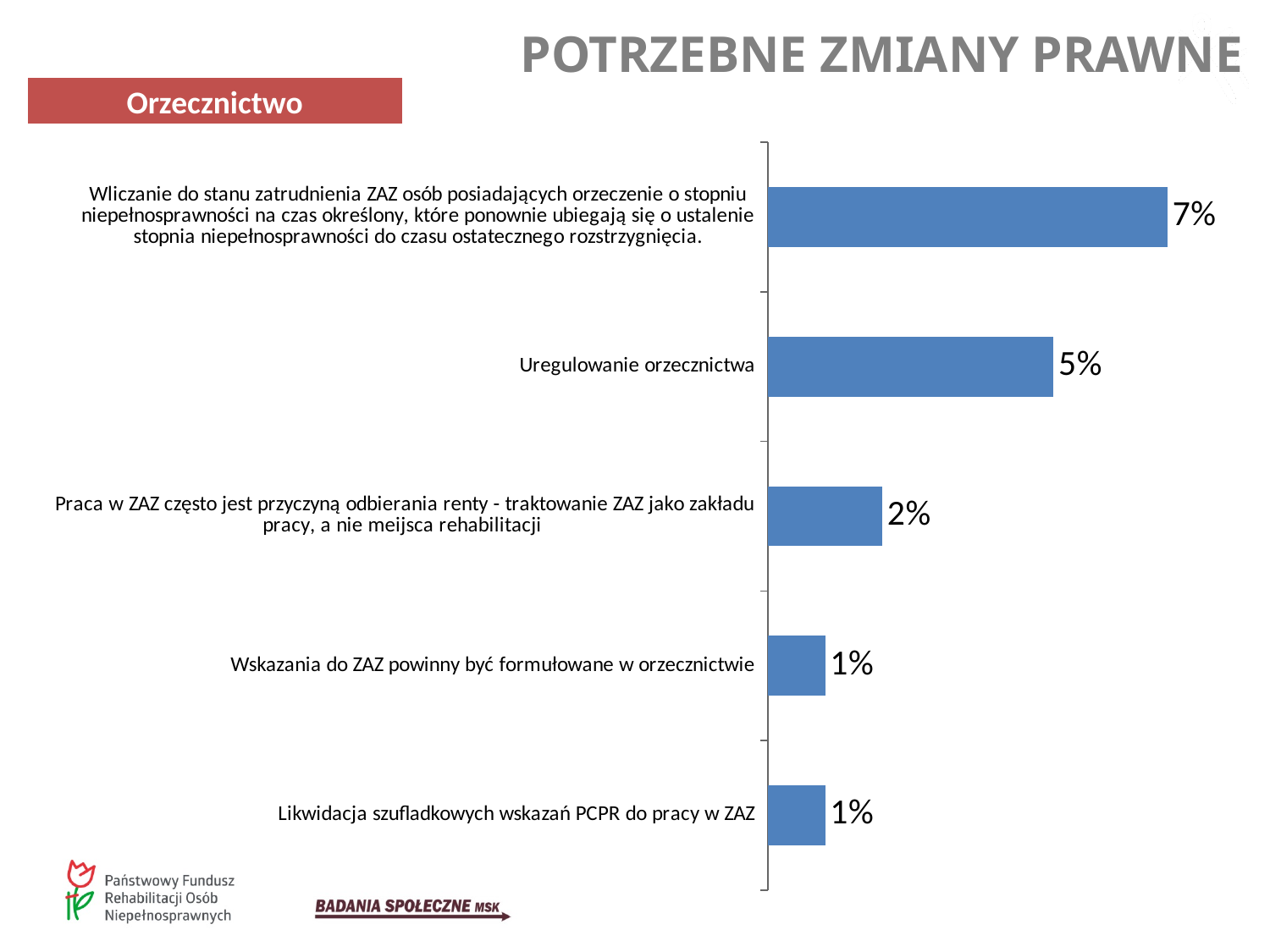
What is the value for "Uregulowanie orzecznictwa"? 5% How many categories are shown in the chart? 5 What is the value of the top bar, for the category beginning "Wliczanie do stanu zatrudnienia ZAZ"? 7% Which is larger: the value for "Uregulowanie orzecznictwa" or the value for "Praca w ZAZ często jest przyczyną odbierania renty"? Uregulowanie orzecznictwa What kind of chart is shown on the slide? Bar chart What is the value for "Wskazania do ZAZ powinny być formułowane w orzecznictwie"? 1% What is the label in the red box above the chart? Orzecznictwo What is the difference between the value for "Uregulowanie orzecznictwa" and the value for "Wskazania do ZAZ powinny być formułowane w orzecznictwie"? 4% What is the value for "Likwidacja szufladkowych wskazań PCPR do pracy w ZAZ"? 1% What is the difference between the highest value and the value for "Uregulowanie orzecznictwa"? 2% What is the value for "Praca w ZAZ często jest przyczyną odbierania renty - traktowanie ZAZ jako zakładu pracy, a nie meijsca rehabilitacji"? 2%